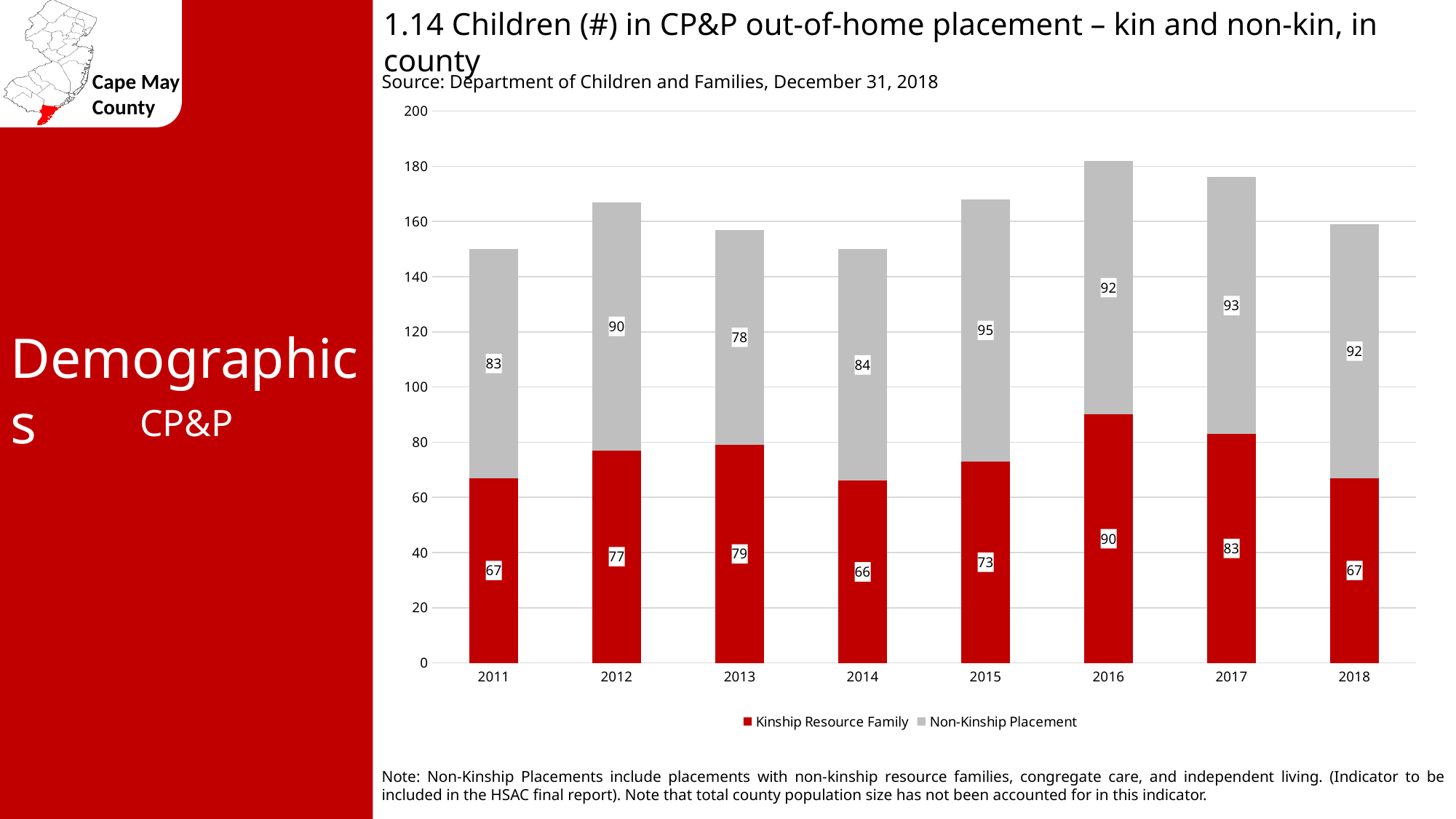
What is the Kinship Resource Family value for 2018? 67 What is the difference between the Non-Kinship Placement and Kinship Resource Family values in 2011? 16 What is the total of the stacked bar for 2016? 182 What is the Non-Kinship Placement value for 2015? 95 Which is larger in 2013, Kinship Resource Family or Non-Kinship Placement? Kinship Resource Family Which year has the lowest Non-Kinship Placement value? 2013 Which year has the highest Kinship Resource Family value? 2016 What is the total of the stacked bar for 2014? 150 What kind of chart is shown on the slide? Stacked bar chart How many series does the legend list? 2 How many years are shown on the x axis? 8 What is the Kinship Resource Family value for 2016? 90